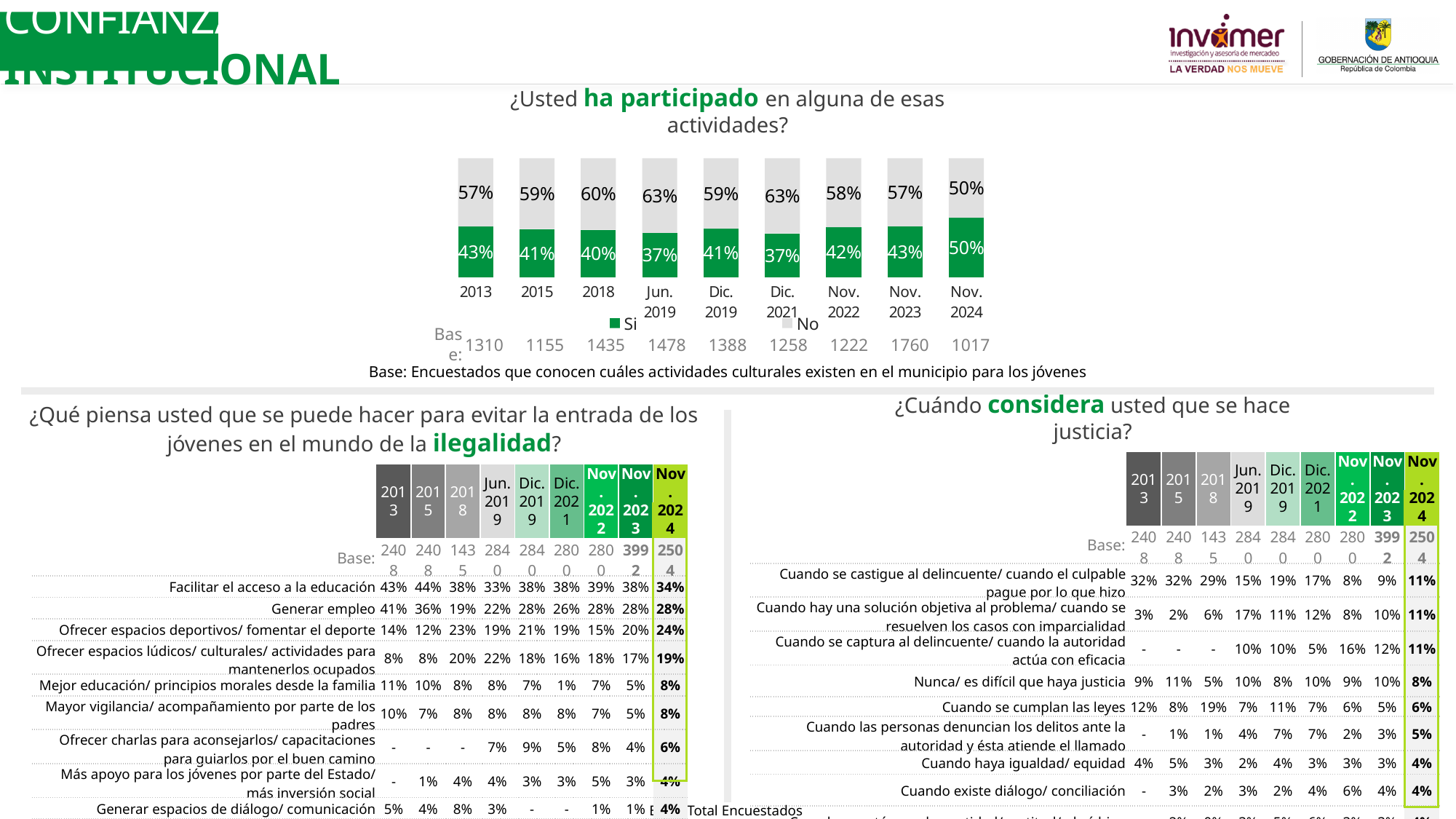
In the chart '¿Usted ha participado en alguna de esas actividades?', which period has the lowest 'No' value? Nov. 2024 In the chart '¿Usted ha participado en alguna de esas actividades?', which period has the highest 'Si' value? Nov. 2024 In the chart '¿Usted ha participado en alguna de esas actividades?', by how many percentage points does the 'Si' value for Nov. 2024 exceed the 'Si' value for Nov. 2023? 7 percentage points In the chart '¿Usted ha participado en alguna de esas actividades?', which has the larger 'Si' value, 2013 or 2015? 2013 What are the legend entries of the chart '¿Usted ha participado en alguna de esas actividades?'? Si, No How many series does the legend of the chart '¿Usted ha participado en alguna de esas actividades?' list? 2 In the chart '¿Usted ha participado en alguna de esas actividades?', does the 'Si' value rise or fall from Nov. 2022 to Nov. 2024? Rise In the chart '¿Usted ha participado en alguna de esas actividades?', what is the 'Si' value for Nov. 2024? 50% In the chart '¿Usted ha participado en alguna de esas actividades?', what is the 'No' value for 2018? 60% How many periods are shown on the x axis of the chart '¿Usted ha participado en alguna de esas actividades?'? 9 In the chart '¿Usted ha participado en alguna de esas actividades?', what is the 'Si' value for Dic. 2019? 41% What kind of chart is '¿Usted ha participado en alguna de esas actividades?'? Stacked bar chart